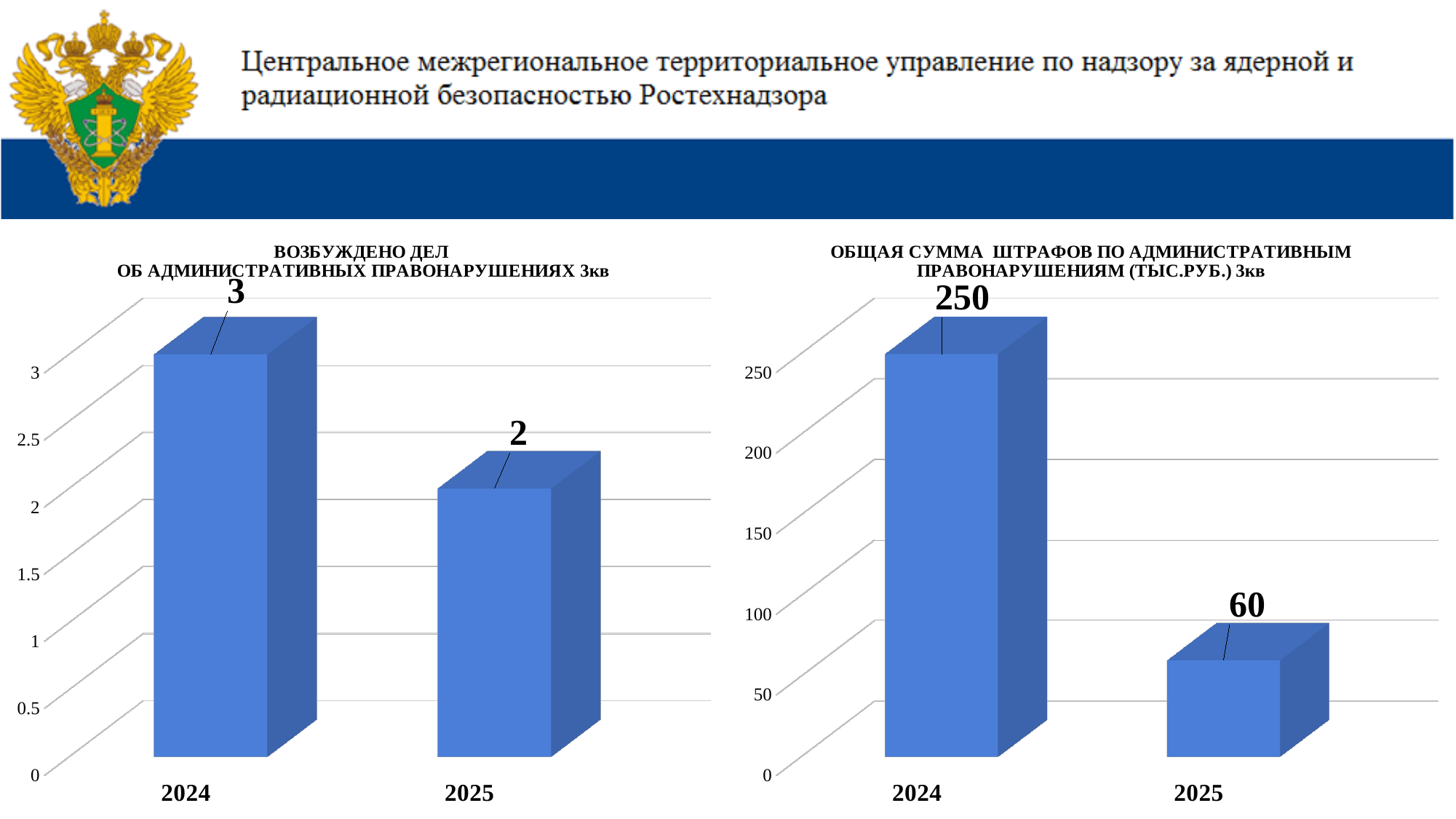
In the right chart (ОБЩАЯ СУММА ШТРАФОВ), do the values rise or fall from 2024 to 2025? Fall In the right chart (ОБЩАЯ СУММА ШТРАФОВ), is the value for 2025 greater or less than 100? less In the right chart (ОБЩАЯ СУММА ШТРАФОВ), which year has the highest value? 2024 In the right chart (ОБЩАЯ СУММА ШТРАФОВ ПО АДМИНИСТРАТИВНЫМ ПРАВОНАРУШЕНИЯМ (ТЫС.РУБ.) 3кв), what is the value for 2025? 60 In the left chart (ВОЗБУЖДЕНО ДЕЛ ОБ АДМИНИСТРАТИВНЫХ ПРАВОНАРУШЕНИЯХ 3кв), what is the value for 2024? 3 In the right chart (ОБЩАЯ СУММА ШТРАФОВ), what is the difference between the 2024 and 2025 values? 190 In the left chart (ВОЗБУЖДЕНО ДЕЛ ОБ АДМИНИСТРАТИВНЫХ ПРАВОНАРУШЕНИЯХ 3кв), what is the value for 2025? 2 In the left chart (ВОЗБУЖДЕНО ДЕЛ), what is the difference between the 2024 and 2025 values? 1 How many categories are shown on the x axis of the left chart (ВОЗБУЖДЕНО ДЕЛ)? 2 What kind of chart is the right chart (ОБЩАЯ СУММА ШТРАФОВ)? Bar chart In the right chart (ОБЩАЯ СУММА ШТРАФОВ ПО АДМИНИСТРАТИВНЫМ ПРАВОНАРУШЕНИЯМ (ТЫС.РУБ.) 3кв), what is the value for 2024? 250 In the left chart (ВОЗБУЖДЕНО ДЕЛ), which year has the lowest value? 2025